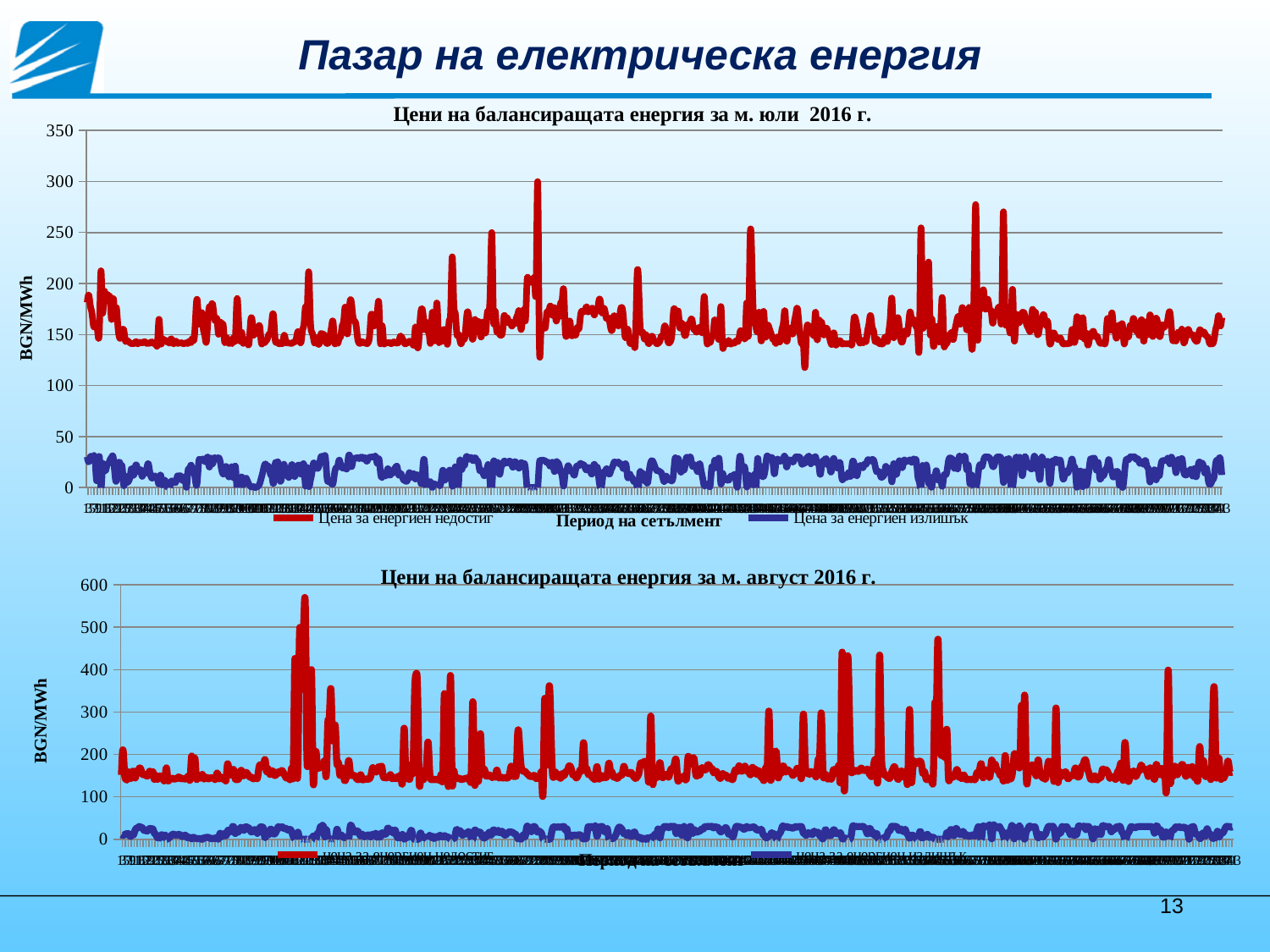
What is the y-axis label of the top chart (July 2016)? BGN/MWh In the top chart (July 2016), which series has higher values, 'Цена за енергиен недостиг' or 'Цена за енергиен излишък'? Цена за енергиен недостиг What is the maximum value shown on the y-axis of the bottom chart (August 2016)? 600 In the top chart (July 2016), which series is drawn in red? Цена за енергиен недостиг In the top chart (July 2016), is the highest peak of the 'Цена за енергиен недостиг' series greater or less than 250? greater In the top chart (July 2016), is the 'Цена за енергиен излишък' series greater or less than 50 throughout the month? less In the bottom chart (August 2016), is the blue series greater or less than 100 throughout the month? less How many series does the legend of the top chart (July 2016) list? 2 In the bottom chart (August 2016), which series has higher values, the red series or the blue series? the red series What kind of chart is the top chart, 'Цени на балансиращата енергия за м. юли 2016 г.'? line chart What kind of chart is the bottom chart, 'Цени на балансиращата енергия за м. август 2016 г.'? line chart